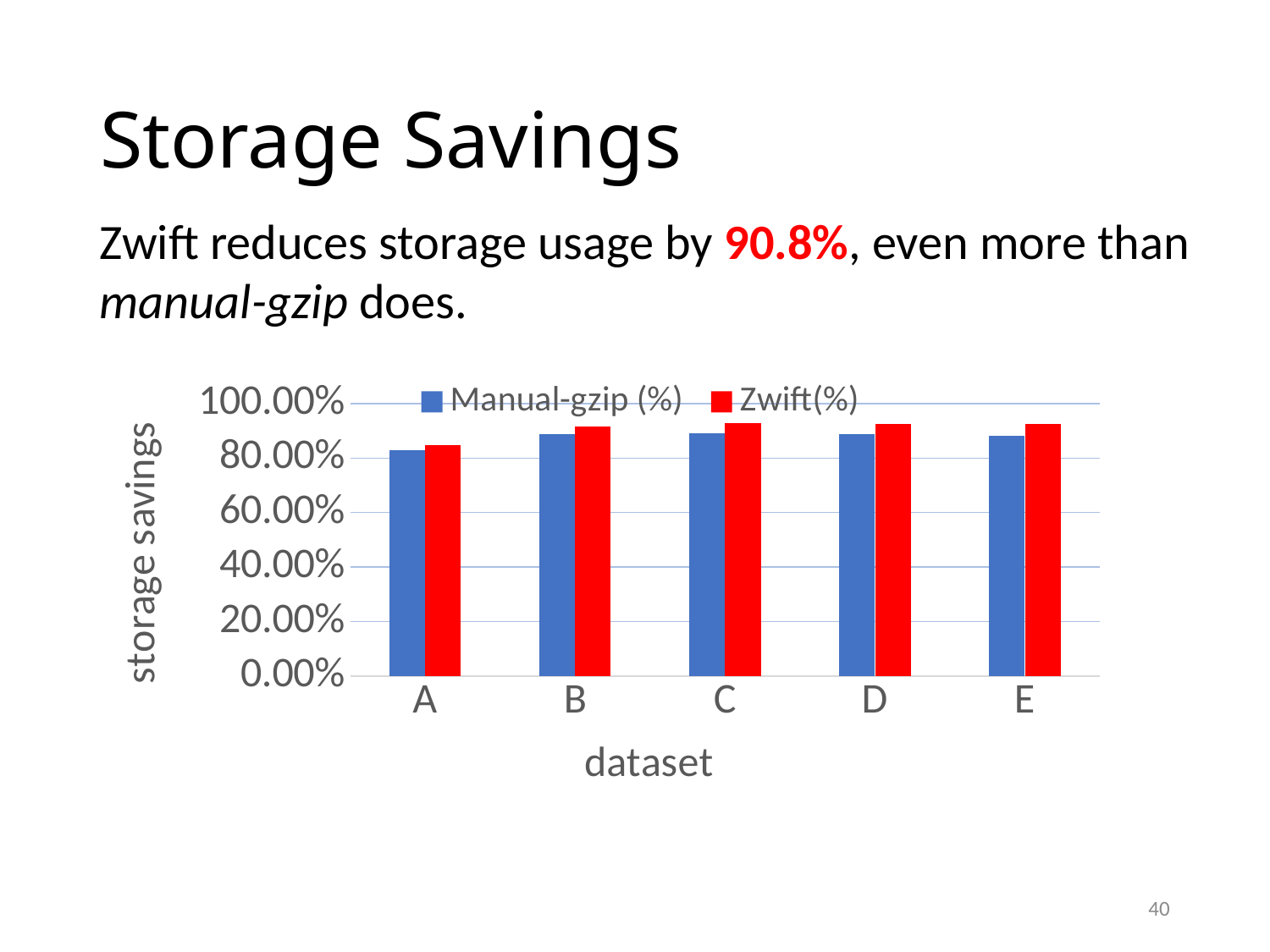
Is the Manual-gzip (%) value for dataset E greater or less than 60.00%? greater What is the title of the chart's y axis? storage savings Which dataset has the lowest Zwift(%) storage savings? A Is the Zwift(%) value for dataset D greater or less than 100.00%? less Which dataset has the lowest Manual-gzip (%) storage savings? A How many datasets are shown on the x axis of the chart? 5 For dataset C, which is larger: Manual-gzip (%) or Zwift(%)? Zwift(%) What kind of chart is shown on the slide? bar chart How many series does the chart's legend list? 2 Is the Manual-gzip (%) value for dataset A greater or less than 80.00%? greater For dataset A, which is larger: Manual-gzip (%) or Zwift(%)? Zwift(%) Which colour represents the Zwift(%) series in the chart? red